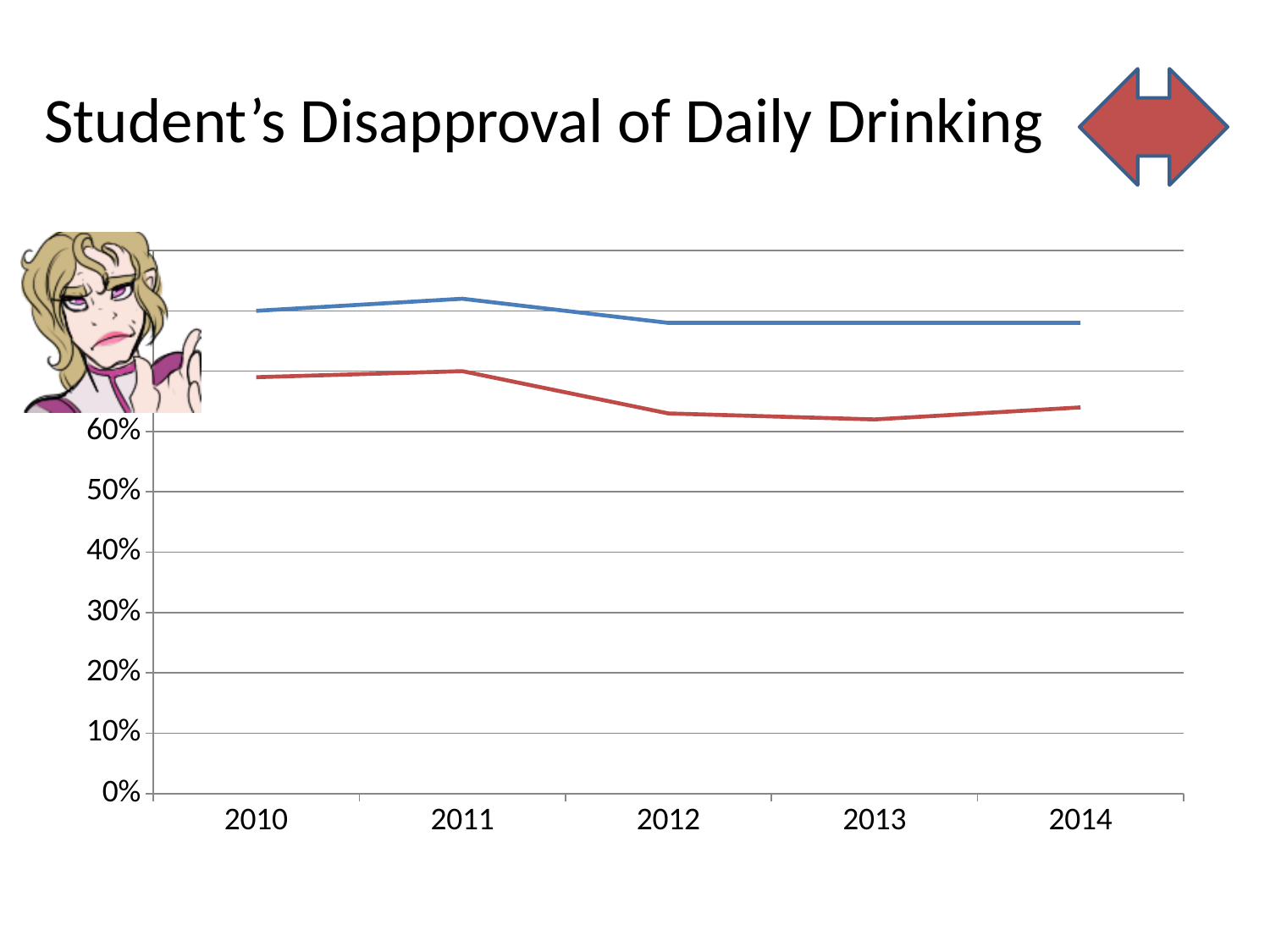
Does the blue line rise or fall from 2011 to 2012? fall How many lines are plotted on the chart? 2 In 2012, which line has the higher value, the blue line or the red line? the blue line In 2010, which line has the lower value, the blue line or the red line? the red line Does the red line rise or fall from 2011 to 2012? fall Is the value of the red line in 2012 greater or less than 50%? greater Is the value of the blue line in 2010 greater or less than 60%? greater What kind of chart is shown on the slide? line chart Is the value of the blue line in 2014 greater or less than 50%? greater How many years are shown on the x axis of the chart? 5 What is the title of the chart on the slide? Student's Disapproval of Daily Drinking Which year is the first one shown on the x axis? 2010